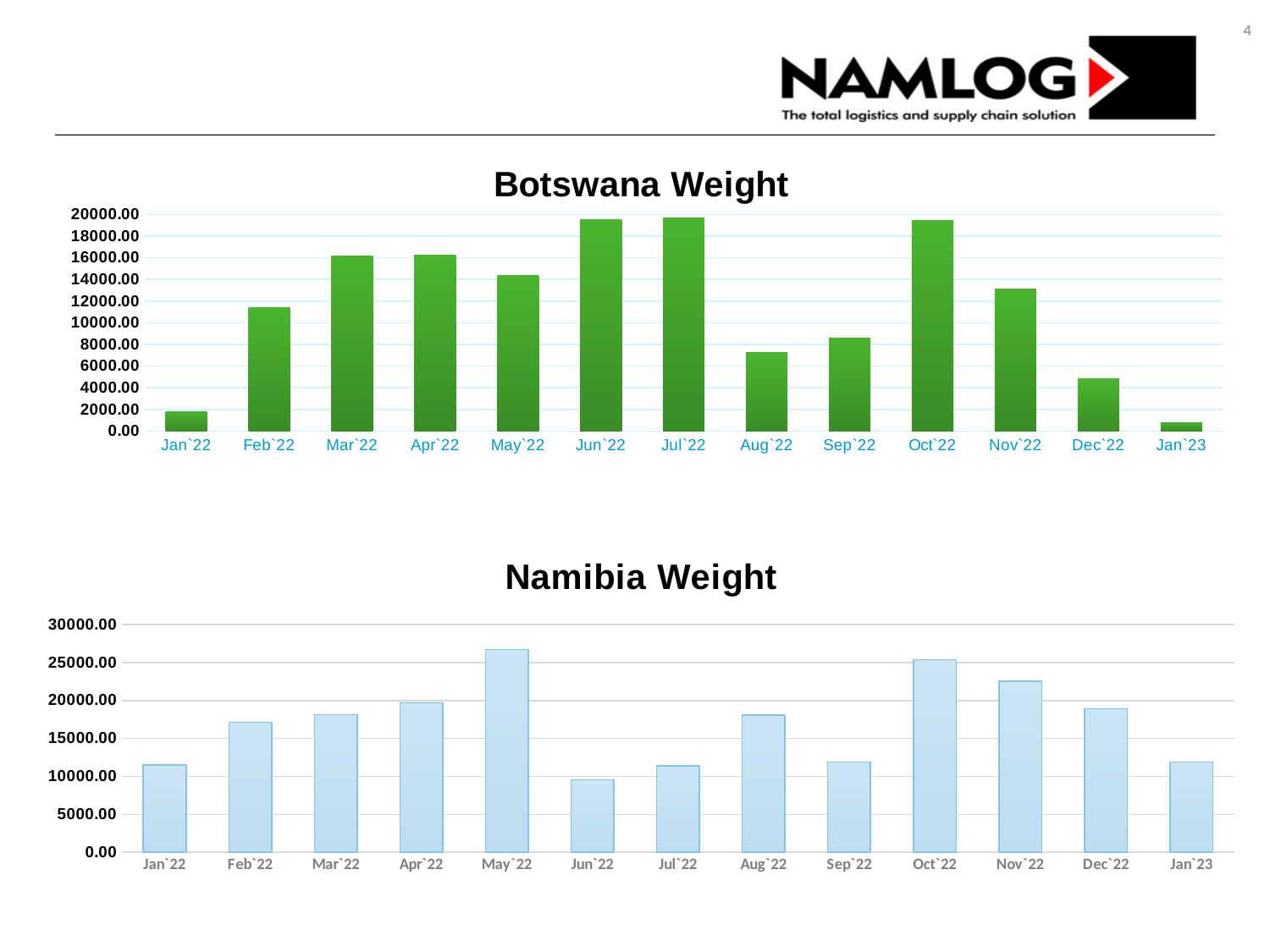
In the Botswana Weight chart, which month has the lowest value? Jan`23 How many months are shown on the x axis of the Botswana Weight chart? 13 In the Namibia Weight chart, do the values rise or fall from Jan`22 to May`22? Rise In the Botswana Weight chart, is the value for Feb`22 greater or less than 10000.00? greater What kind of chart is the Botswana Weight chart? Bar chart In the Botswana Weight chart, is the value for Dec`22 greater or less than 6000.00? less In the Namibia Weight chart, which month has the highest value? May`22 In the Namibia Weight chart, which month has the lowest value? Jun`22 In the Botswana Weight chart, which is larger, the value for Nov`22 or the value for Sep`22? Nov`22 In the Namibia Weight chart, which is larger, the value for Nov`22 or the value for Dec`22? Nov`22 In the Botswana Weight chart, is the value for Aug`22 greater or less than 8000.00? less